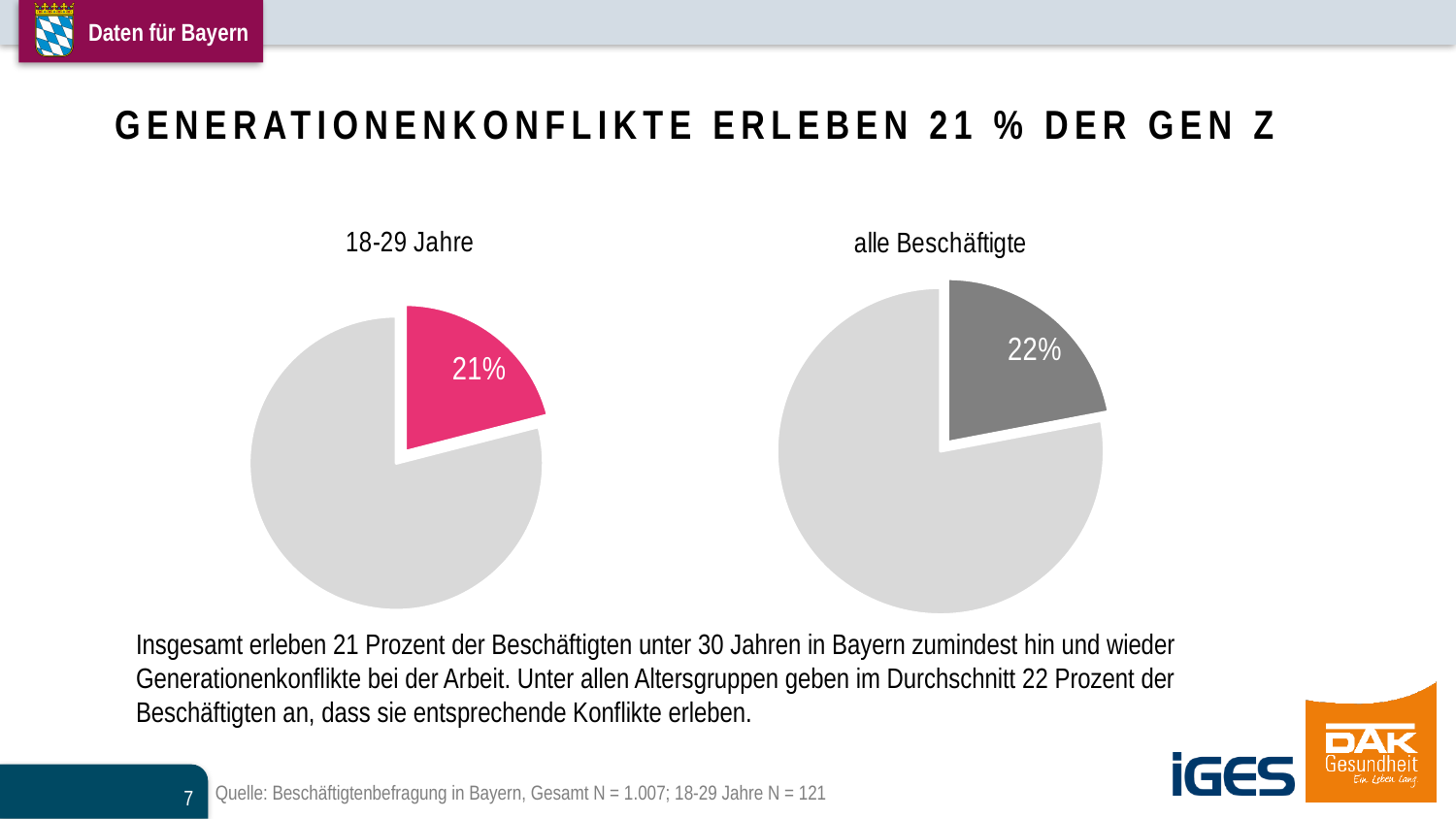
In the pie chart titled "18-29 Jahre", what share of the pie does the pink slice represent? 21% What is the title of the pie chart on the right side of the slide? alle Beschäftigte What kind of chart is used for "18-29 Jahre"? Pie chart In the pie chart titled "18-29 Jahre", is the labelled slice greater or less than 50%? less What colour is the labelled slice in the pie chart titled "18-29 Jahre"? Pink In the pie chart titled "alle Beschäftigte", what share of the pie does the dark grey slice represent? 22% How many pie charts are shown on the slide? 2 Which chart has the larger labelled slice, "18-29 Jahre" or "alle Beschäftigte"? alle Beschäftigte In the pie chart titled "alle Beschäftigte", what percentage is shown on the highlighted slice? 22% What is the difference in percentage points between the labelled slice in "alle Beschäftigte" and the labelled slice in "18-29 Jahre"? 1 percentage point In the pie chart titled "18-29 Jahre", what percentage is shown on the highlighted slice? 21%